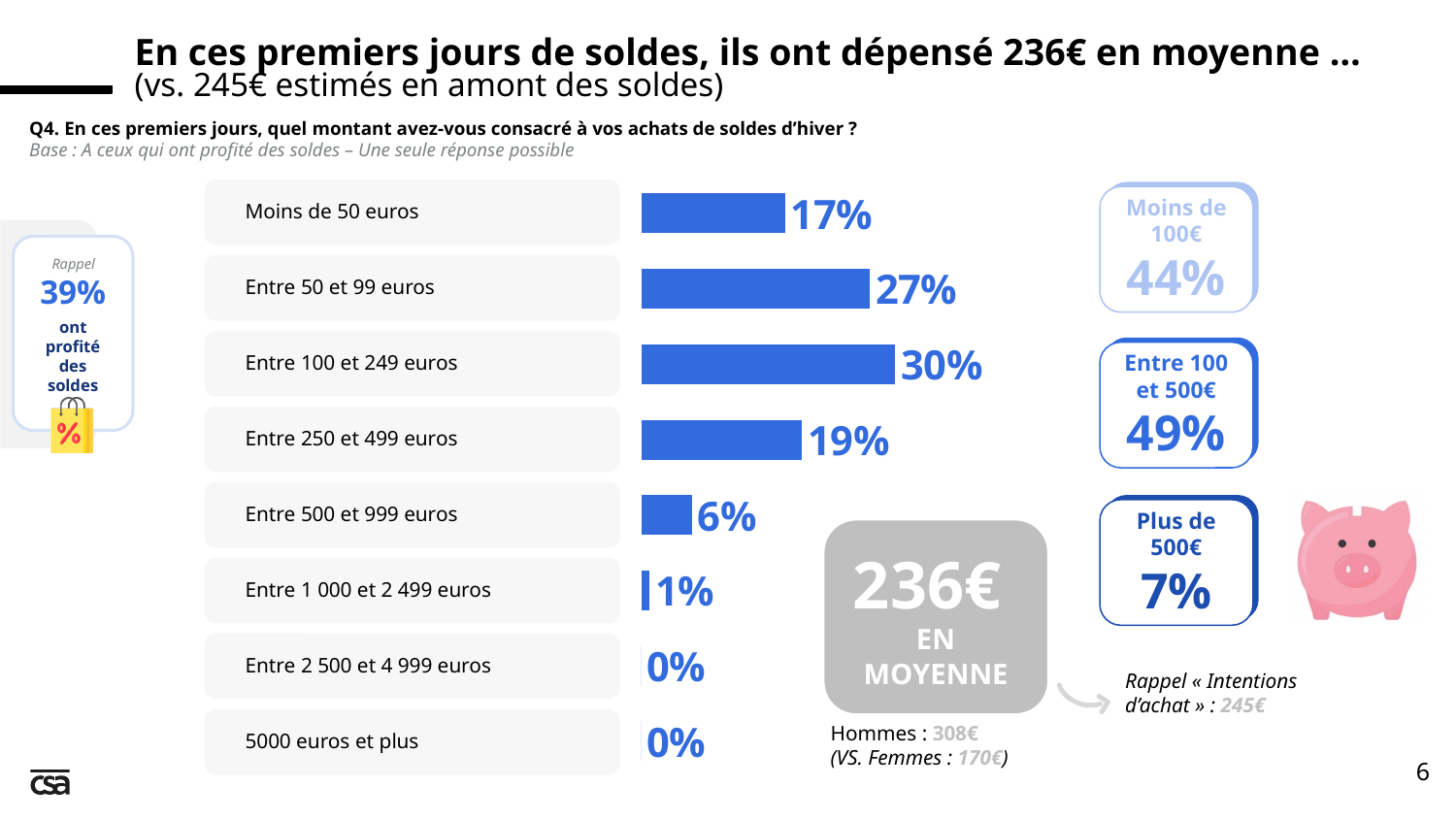
What is the combined percentage of 'Entre 100 et 249 euros' and 'Entre 250 et 499 euros'? 49% What is the value for 'Entre 1 000 et 2 499 euros'? 1% Which is larger: the value for 'Moins de 50 euros' or for 'Entre 250 et 499 euros'? Entre 250 et 499 euros What is the difference in percentage points between 'Entre 100 et 249 euros' and 'Entre 50 et 99 euros'? 3 percentage points Which spending category has the highest percentage? Entre 100 et 249 euros What is the value shown for 'Moins de 50 euros'? 17% What percentage is shown for 'Entre 500 et 999 euros'? 6% What average amount spent is highlighted in the grey box next to the chart? 236€ Do the values rise or fall going down the chart from 'Entre 100 et 249 euros' to '5000 euros et plus'? Fall How many spending categories are shown in the bar chart? 8 What percentage of respondents spent between 100 and 249 euros? 30% What type of chart is used to show the spending categories? Bar chart